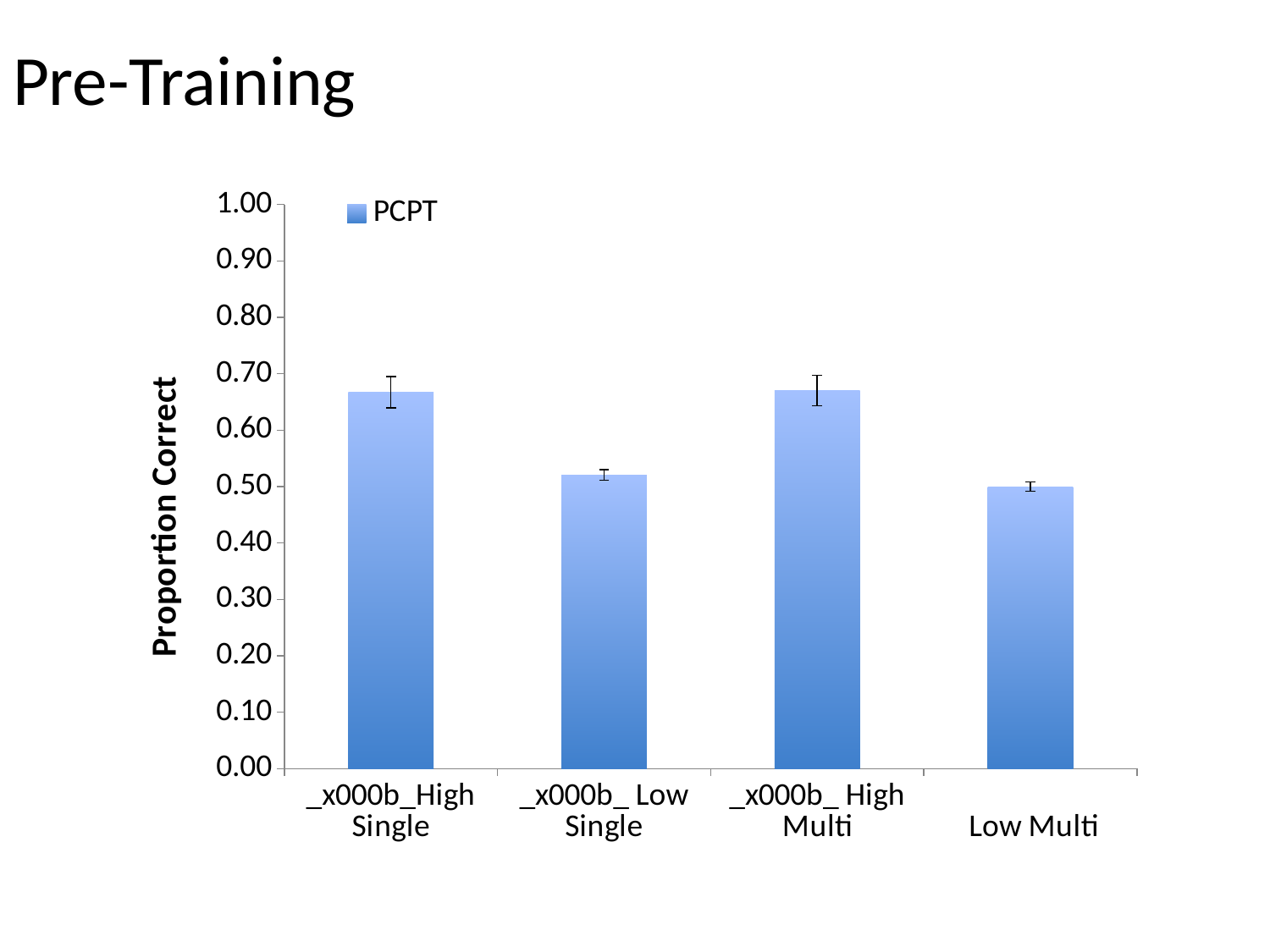
How many series does the chart's legend list? 1 Which has the larger value, Low Multi or High Multi? High Multi Is the value for Low Multi greater or less than 0.60? less What is the title of the chart's vertical axis? Proportion Correct Which has the larger value, High Single or Low Single? High Single Is the value for High Single greater or less than 0.70? less What kind of chart is shown on the slide? bar chart What series name is shown in the chart's legend? PCPT Is the value for Low Single greater or less than 0.60? less How many categories are plotted on the x axis of the chart? 4